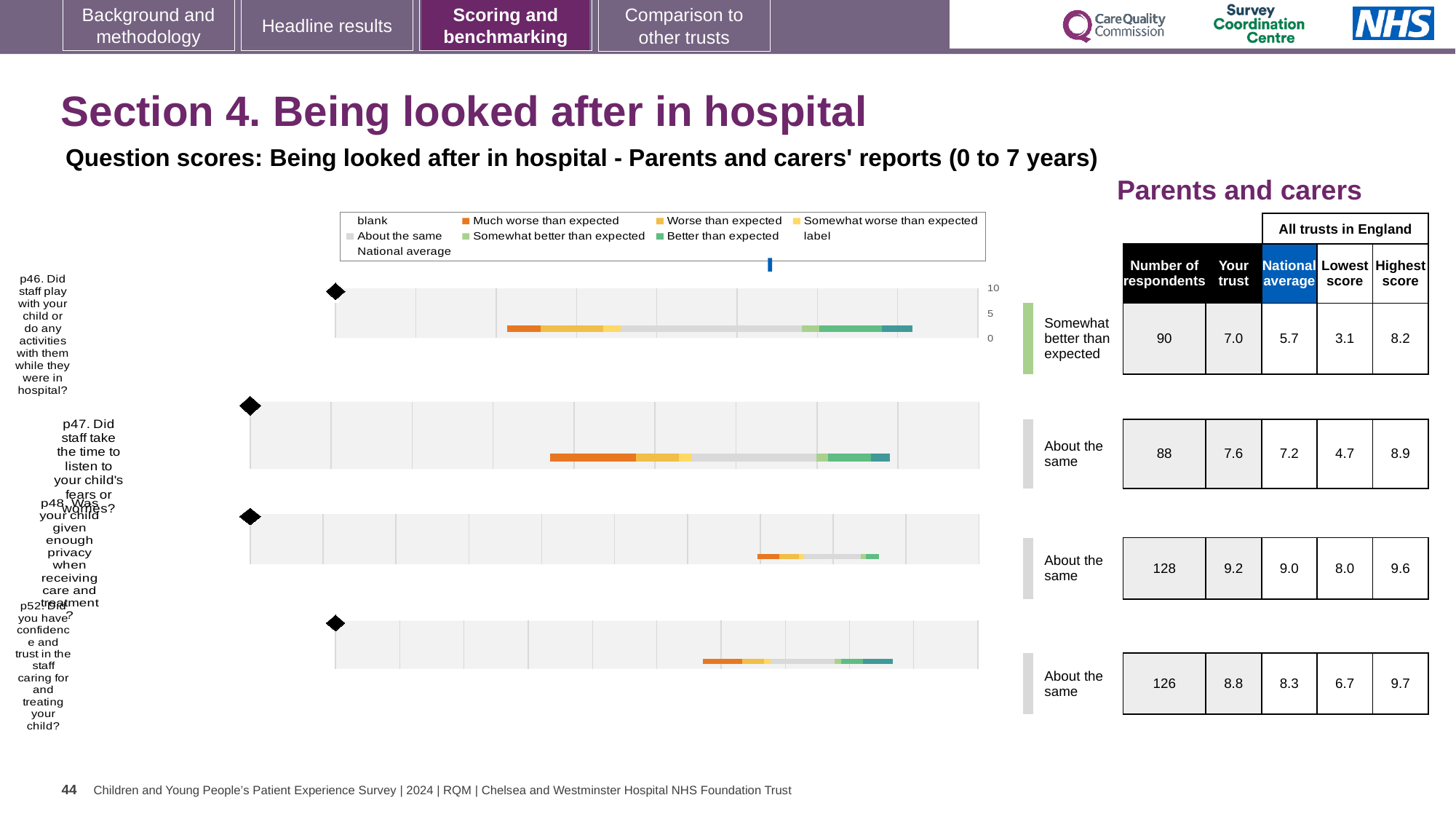
For p47 (Did staff take the time to listen to your child's fears or worries?), what is the national average score? 7.2 Which question has the highest 'Your trust' score on this slide? p48 For p48 (Was your child given enough privacy when receiving care and treatment?), how many respondents are there? 128 Which question has the lowest 'Your trust' score on this slide? p46 For p47, what is the lowest score among all trusts in England? 4.7 For p47, which is larger: the 'Your trust' score or the national average? Your trust For p46 (Did staff play with your child or do any activities with them while they were in hospital?), what is the 'Your trust' score? 7.0 What benchmark category is shown for p46 (Did staff play with your child or do any activities with them while they were in hospital?)? Somewhat better than expected For p52 (Did you have confidence and trust in the staff caring for and treating your child?), what is the highest score among all trusts in England? 9.7 For p52, what is the difference between the 'Your trust' score and the national average? 0.5 How many question score charts (p46, p47, p48, p52) are shown on the slide? 4 What kind of chart is used to show the question scores for p46 to p52 on this slide? bar chart